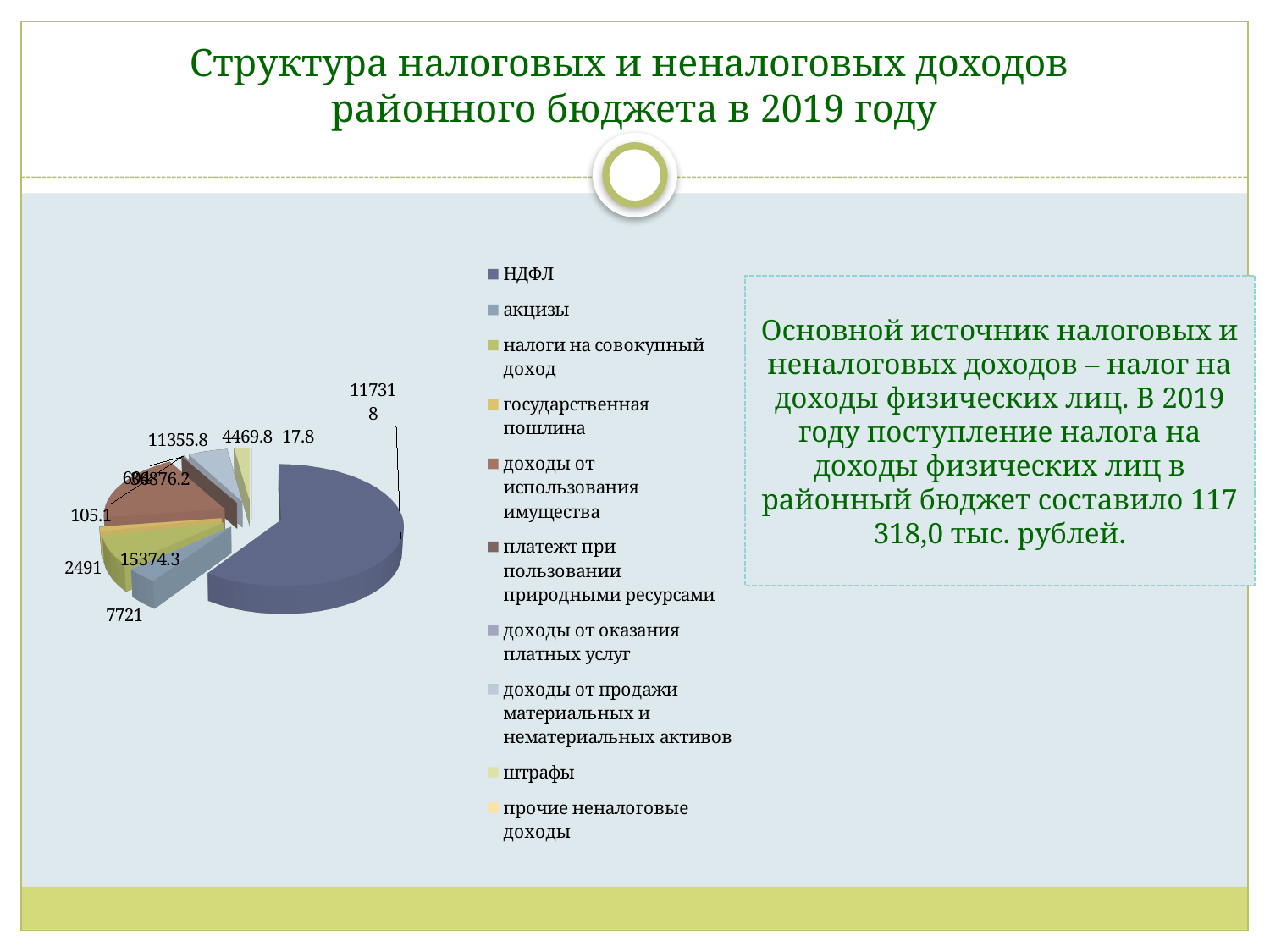
How many categories does the legend of the pie chart list? 10 Which category is listed first in the pie chart's legend? НДФЛ What is the value shown for акцизы in the pie chart? 7721 What is the value shown for НДФЛ in the pie chart? 117318 What is the title of the slide containing the pie chart? Структура налоговых и неналоговых доходов районного бюджета в 2019 году Which category has the largest slice of the pie chart? НДФЛ Which is larger in the pie chart, НДФЛ or акцизы? НДФЛ What kind of chart is shown on the slide? pie chart What is the smallest data label value printed on the pie chart? 17.8 Is the value for НДФЛ greater or less than 100000? greater